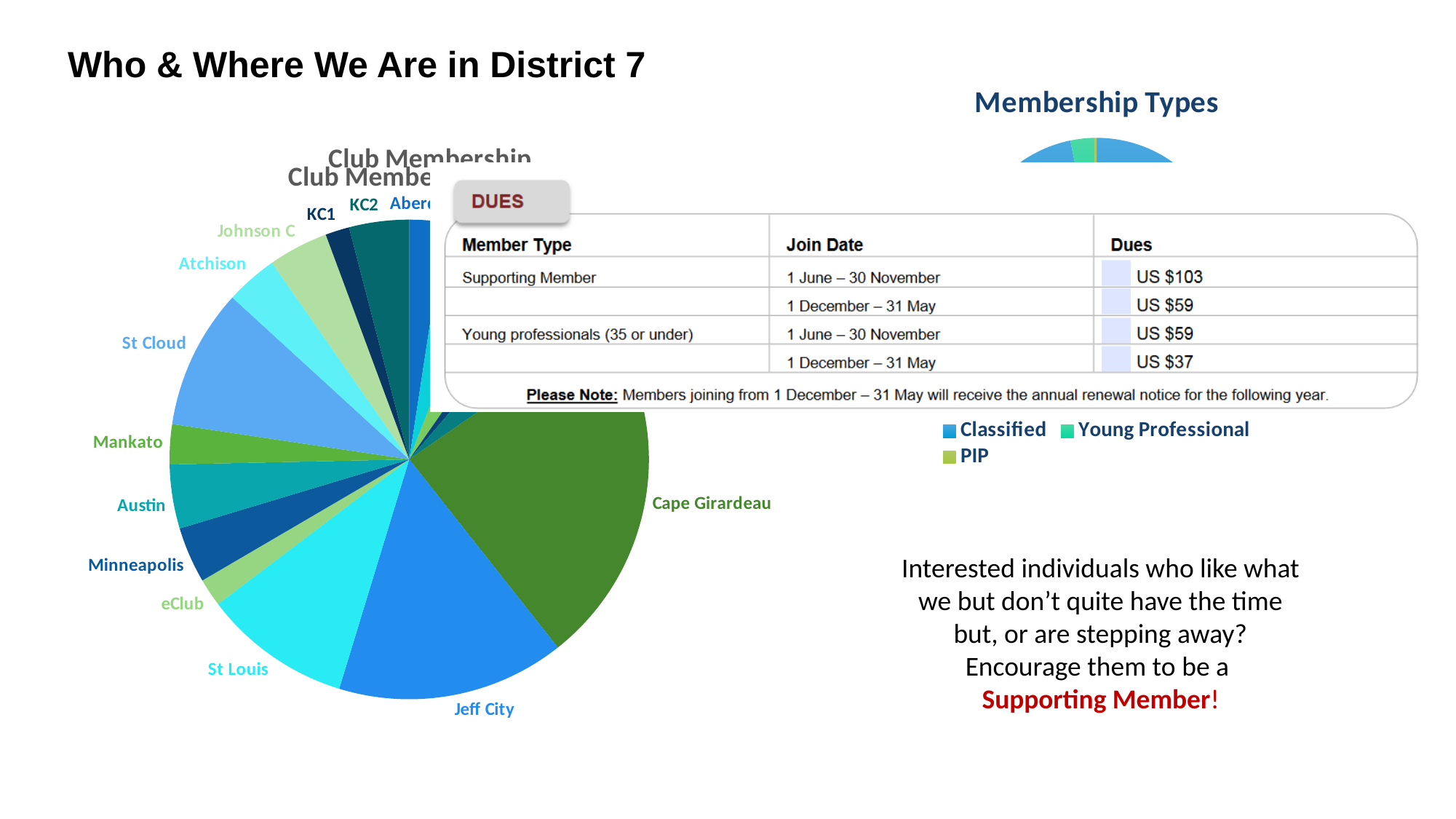
In the Club Membership pie chart, which club has the largest slice? Cape Girardeau In the Club Membership pie chart, which slice is larger, Cape Girardeau or Jeff City? Cape Girardeau In the Club Membership pie chart, which slice is larger, St Louis or eClub? St Louis What kind of chart is the Club Membership chart? pie chart How many membership types does the legend of the Membership Types chart list? 3 In the Club Membership pie chart, which slice is larger, Jeff City or St Louis? Jeff City What are the legend entries of the Membership Types chart? Classified, Young Professional, PIP What is the title of the chart in the upper right of the slide? Membership Types